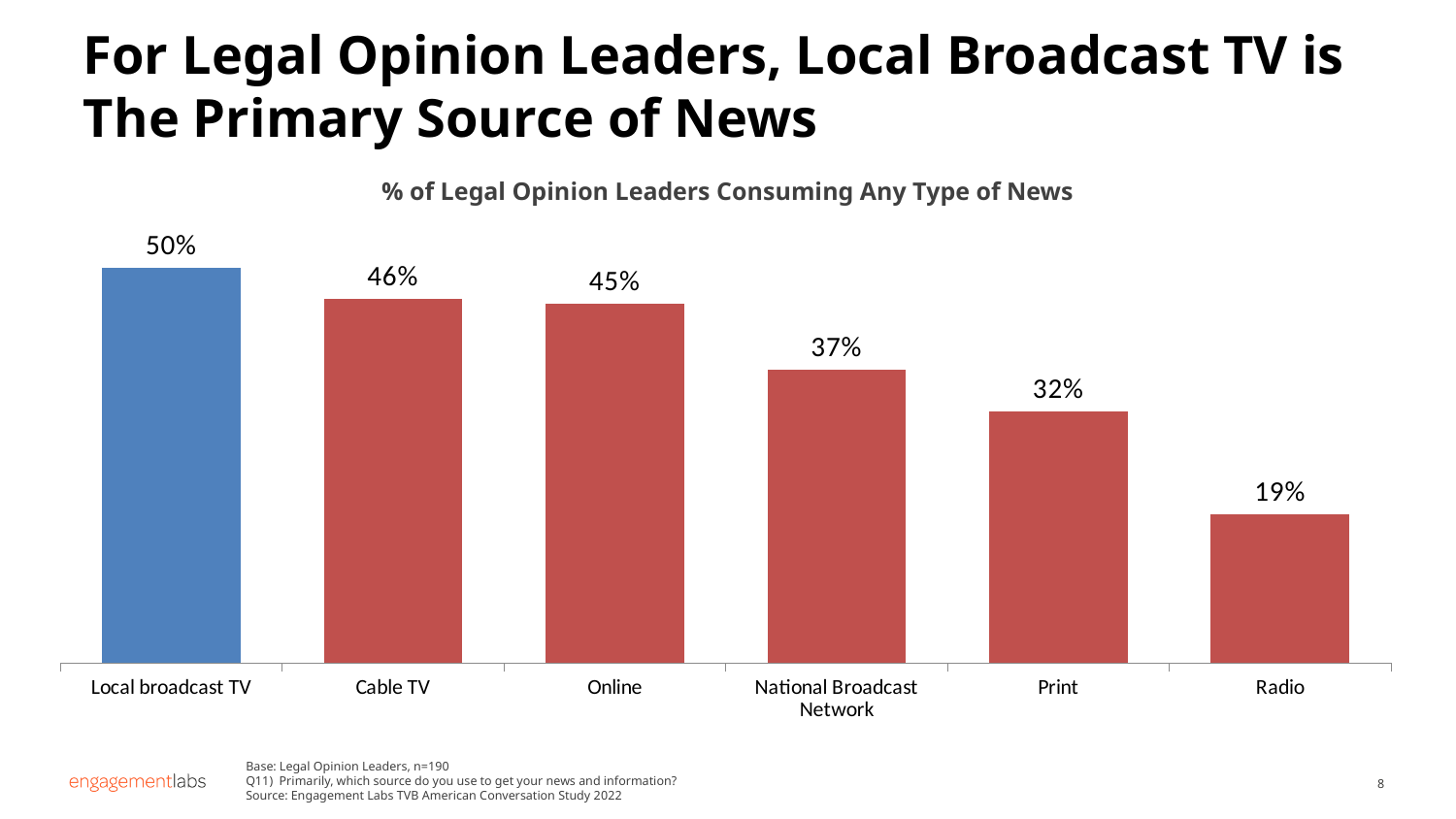
How many news sources are shown in the chart? 6 Which bar is coloured differently from the others? Local broadcast TV Do the values rise or fall from left to right across the chart? Fall Which is larger, the value for Print or the value for National Broadcast Network? National Broadcast Network Which news source has the highest percentage? Local broadcast TV What is the value shown for Radio? 19% Which news source has the lowest percentage? Radio What is the difference between the values for National Broadcast Network and Radio? 18% What percentage of Legal Opinion Leaders use Local broadcast TV as a news source? 50% What is the difference between the values for Cable TV and Print? 14% What kind of chart is shown on the slide? Bar chart What is the value shown for Online? 45%